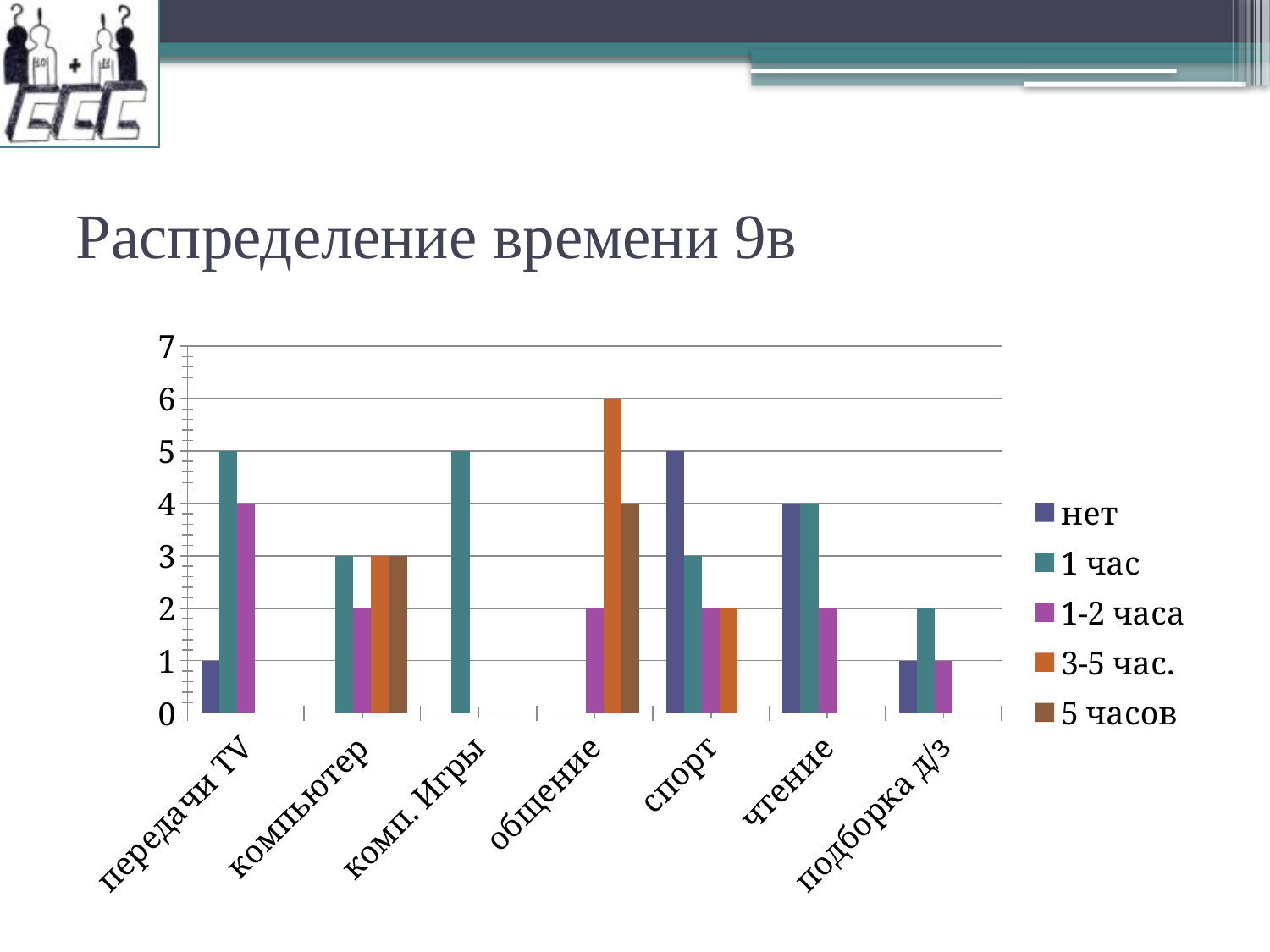
How many series does the legend list? 5 How many categories are shown on the x axis? 7 Which category has the tallest bar in the chart? общение What is the title of the chart? Распределение времени 9в Is the '3-5 час.' value for 'общение' greater or less than 5? greater What is the value of the 'нет' series for 'спорт'? 5 What is the value of the '1-2 часа' series for 'передачи TV'? 4 What is the value of the '1 час' series for 'комп. Игры'? 5 Which is larger: the '5 часов' value for 'общение' or the '5 часов' value for 'компьютер'? общение What is the value of the '3-5 час.' series for 'общение'? 6 What type of chart is shown on the slide? bar chart What is the difference between the '1 час' value and the 'нет' value for 'передачи TV'? 4